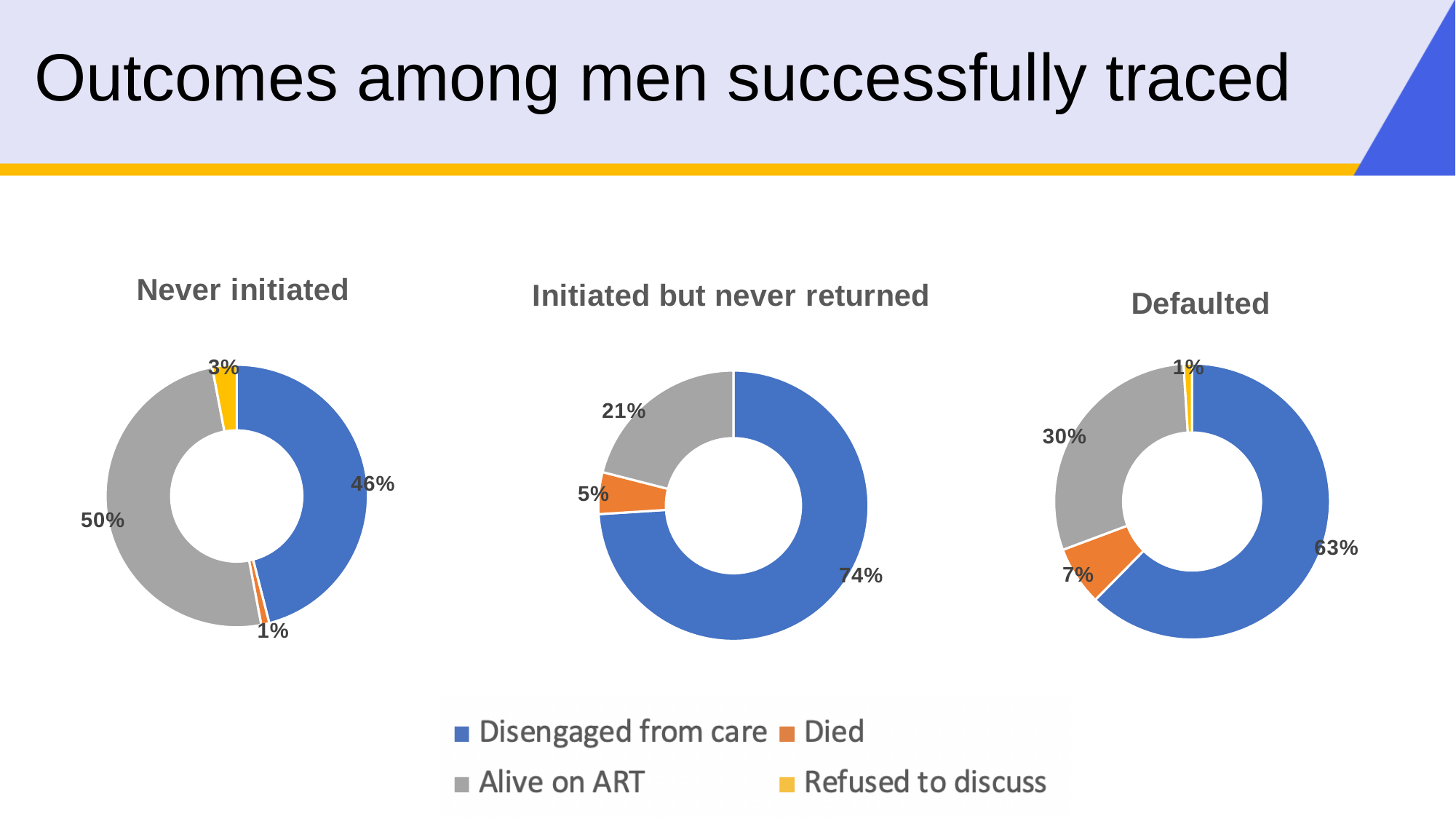
In the 'Initiated but never returned' chart, what share is Disengaged from care? 74% How many series does the legend list? 4 In the 'Defaulted' chart, what share is Alive on ART? 30% In the 'Defaulted' chart, what is the difference between the Disengaged from care share and the Alive on ART share? 33% In the 'Defaulted' chart, what share Refused to discuss? 1% In the 'Never initiated' chart, what share is Disengaged from care? 46% In the 'Initiated but never returned' chart, which outcome has the smallest share? Died What kind of chart is used for 'Defaulted'? Doughnut (pie) chart In the 'Initiated but never returned' chart, what share Died? 5% In the 'Never initiated' chart, what share is Alive on ART? 50% In the 'Defaulted' chart, which outcome has the largest share? Disengaged from care Which is larger in the 'Never initiated' chart: the Alive on ART share or the Disengaged from care share? Alive on ART